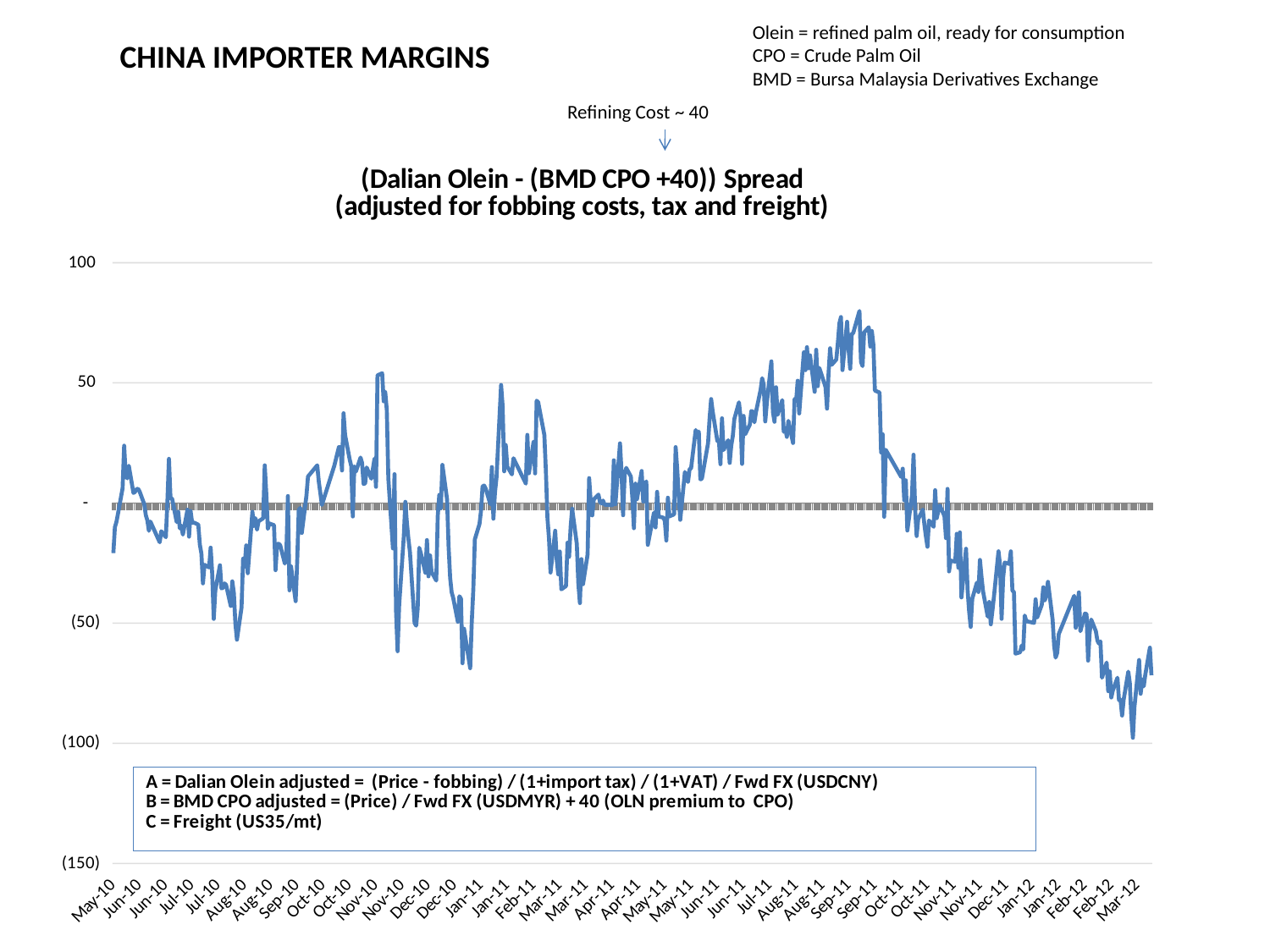
What is the highest value shown on the vertical axis? 100 Is the value of the spread at Jul-11 greater or less than 0? greater Is the value of the spread at Dec-11 greater or less than 0? less Is the value of the spread at Mar-12 greater or less than (50)? less Does the spread rise or fall between Sep-11 and Mar-12? fall What kind of chart is shown on the slide? line chart What is the title of the chart? (Dalian Olein - (BMD CPO +40)) Spread (adjusted for fobbing costs, tax and freight) What is the lowest value shown on the vertical axis? (150) Does the spread rise or fall between May-11 and Sep-11? rise What refining cost is noted above the chart title? ~ 40